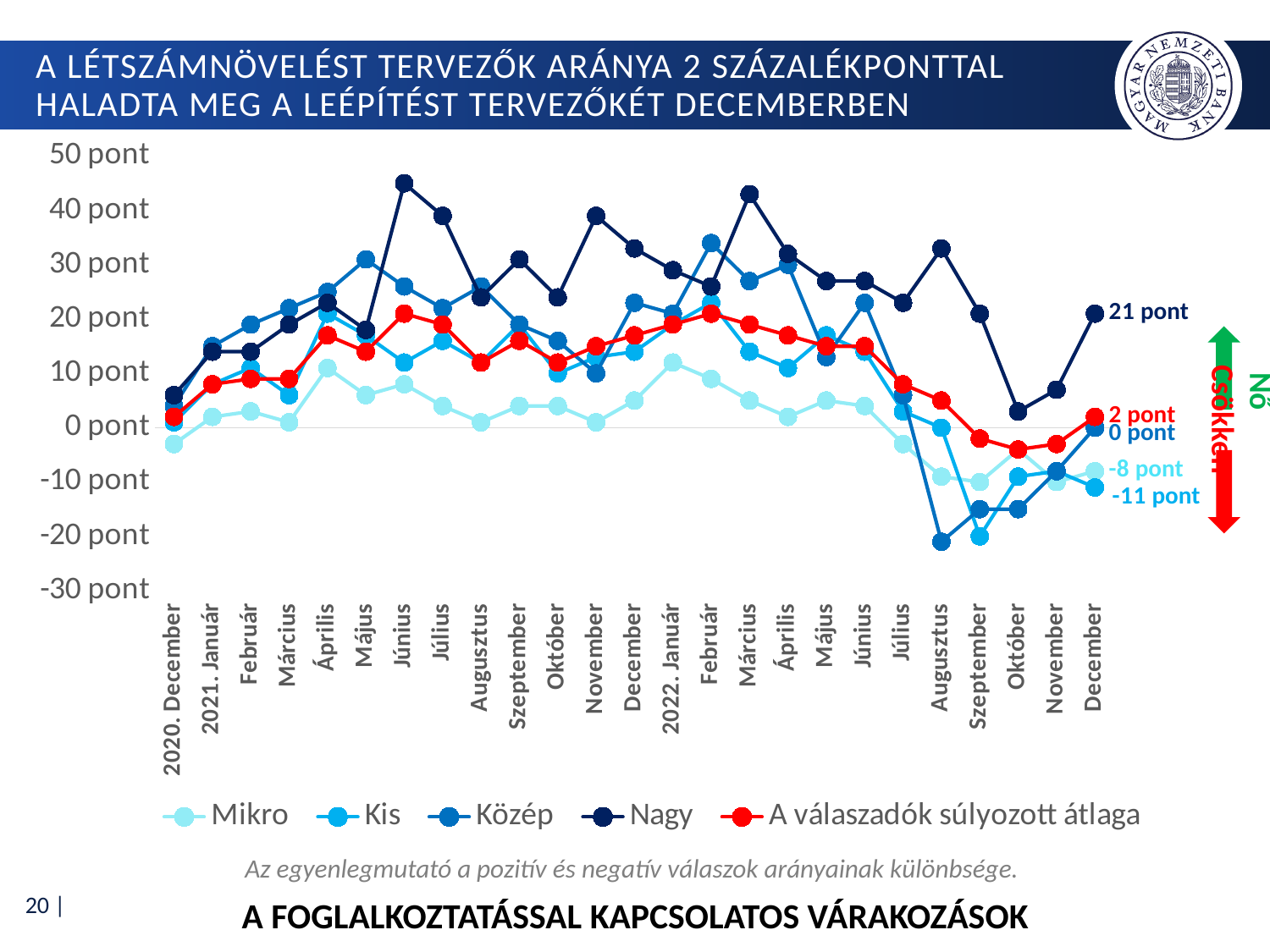
What kind of chart is shown on the slide? Line chart What is the value of the Mikro series in December 2022? -8 pont What is the value of the Kis series in December 2022? -11 pont Which series has the highest value in December 2022? Nagy Is the value of the Nagy series in Június 2021 greater or less than 40 pont? greater What is the value of the Nagy series in December 2022? 21 pont How many series does the legend list? 5 Which series has the lowest value in December 2022? Kis How many months (data points) are shown along the x axis? 25 What is the value of 'A válaszadók súlyozott átlaga' in December 2022? 2 pont What is the value of the Közép series in December 2022? 0 pont By how much does the Nagy value exceed the weighted average ('A válaszadók súlyozott átlaga') in December 2022? 19 pont